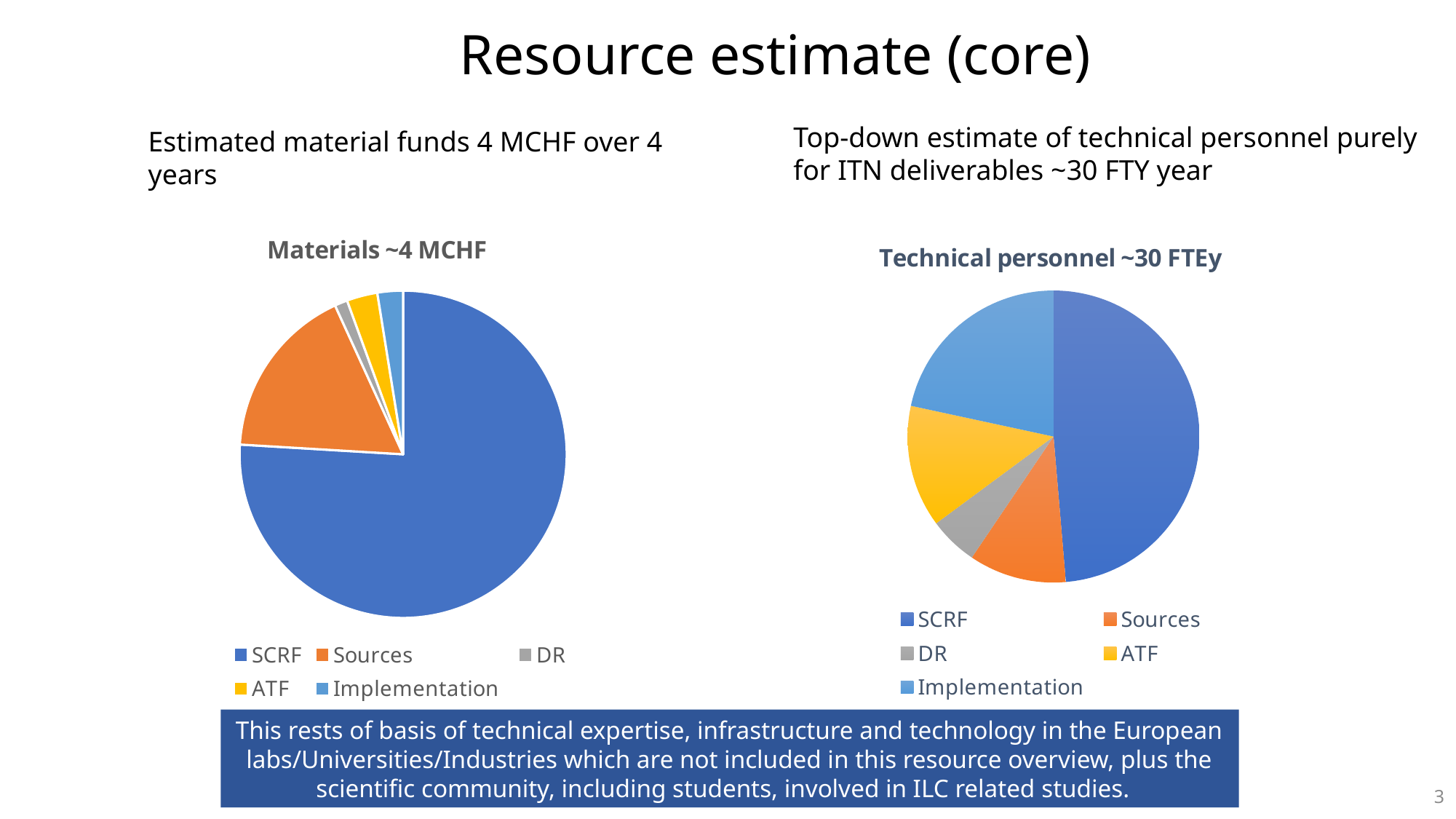
How many categories does the legend of the "Materials ~4 MCHF" chart list? 5 In the "Materials ~4 MCHF" chart, which category has the smallest slice? DR How many categories does the legend of the "Technical personnel ~30 FTEy" chart list? 5 In the "Technical personnel ~30 FTEy" chart, which category has the largest slice? SCRF In the "Technical personnel ~30 FTEy" chart, which category has the smallest slice? DR In the "Technical personnel ~30 FTEy" chart, which slice is larger, Implementation or Sources? Implementation In the "Materials ~4 MCHF" chart, which slice is larger, Sources or ATF? Sources What kind of chart is the "Materials ~4 MCHF" chart? pie chart In the "Materials ~4 MCHF" chart, which category has the largest slice? SCRF What is the title of the pie chart on the right of the slide? Technical personnel ~30 FTEy What kind of chart is the "Technical personnel ~30 FTEy" chart? pie chart In the "Materials ~4 MCHF" chart, what colour is the Sources slice? orange